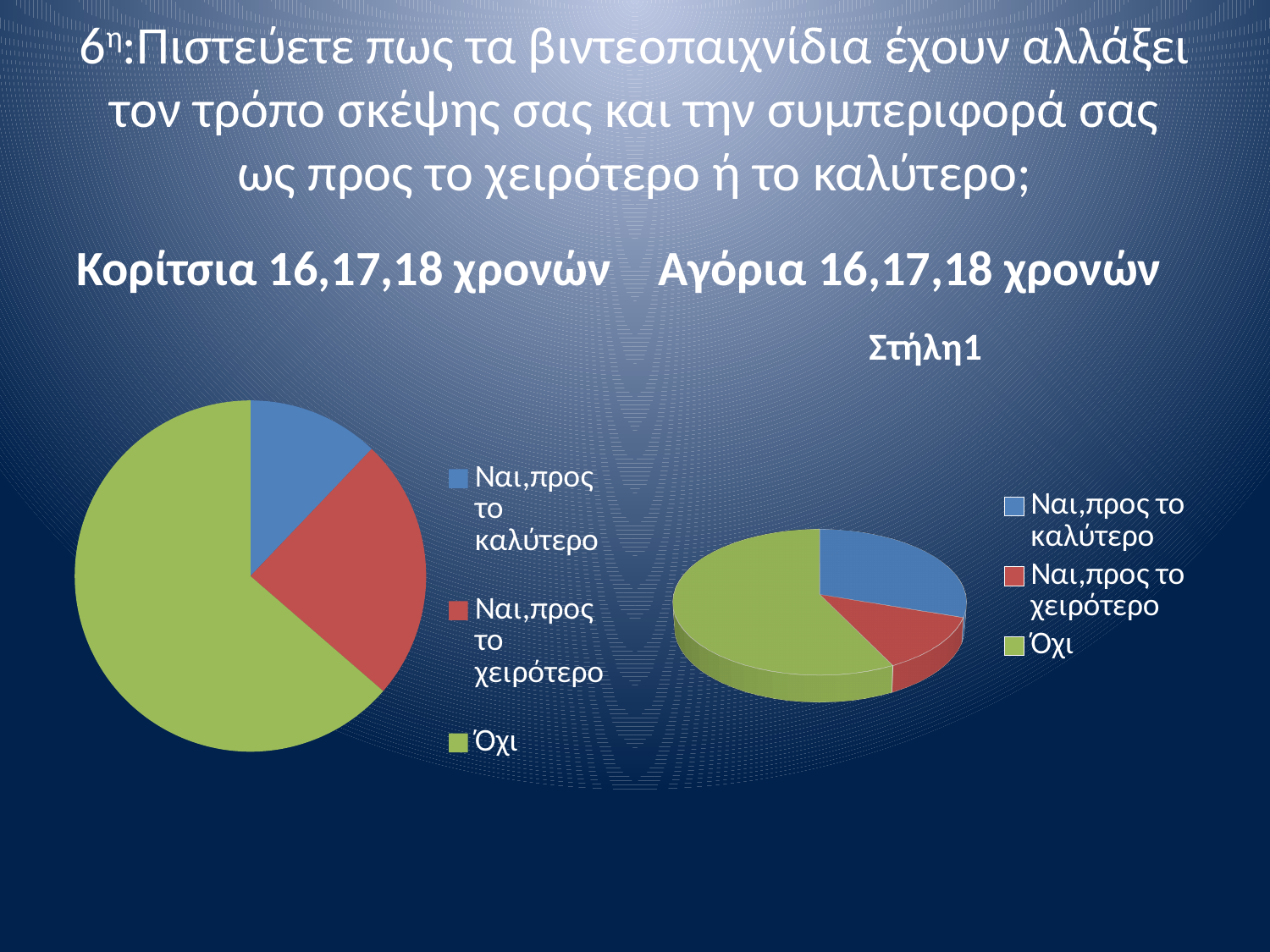
In the Κορίτσια 16,17,18 χρονών pie chart, which slice is larger: Ναι,προς το καλύτερο or Ναι,προς το χειρότερο? Ναι,προς το χειρότερο In the Κορίτσια 16,17,18 χρονών pie chart, which category has the largest slice? Όχι What kind of chart is used for the Αγόρια 16,17,18 χρονών data on the right? Pie chart In the Αγόρια 16,17,18 χρονών pie chart, which category has the smallest slice? Ναι,προς το χειρότερο In the Αγόρια 16,17,18 χρονών pie chart, which category has the largest slice? Όχι In the Κορίτσια 16,17,18 χρονών pie chart, how many slices are there? 3 What is the title shown above the Αγόρια 16,17,18 χρονών pie chart? Στήλη1 In the Κορίτσια 16,17,18 χρονών pie chart, what colour represents the Όχι category? Green What kind of chart is used for the Κορίτσια 16,17,18 χρονών data on the left? Pie chart In the Αγόρια 16,17,18 χρονών pie chart, which slice is larger: Ναι,προς το καλύτερο or Ναι,προς το χειρότερο? Ναι,προς το καλύτερο In the Αγόρια 16,17,18 χρονών pie chart, how many categories does the legend list? 3 In the Κορίτσια 16,17,18 χρονών pie chart, which category has the smallest slice? Ναι,προς το καλύτερο